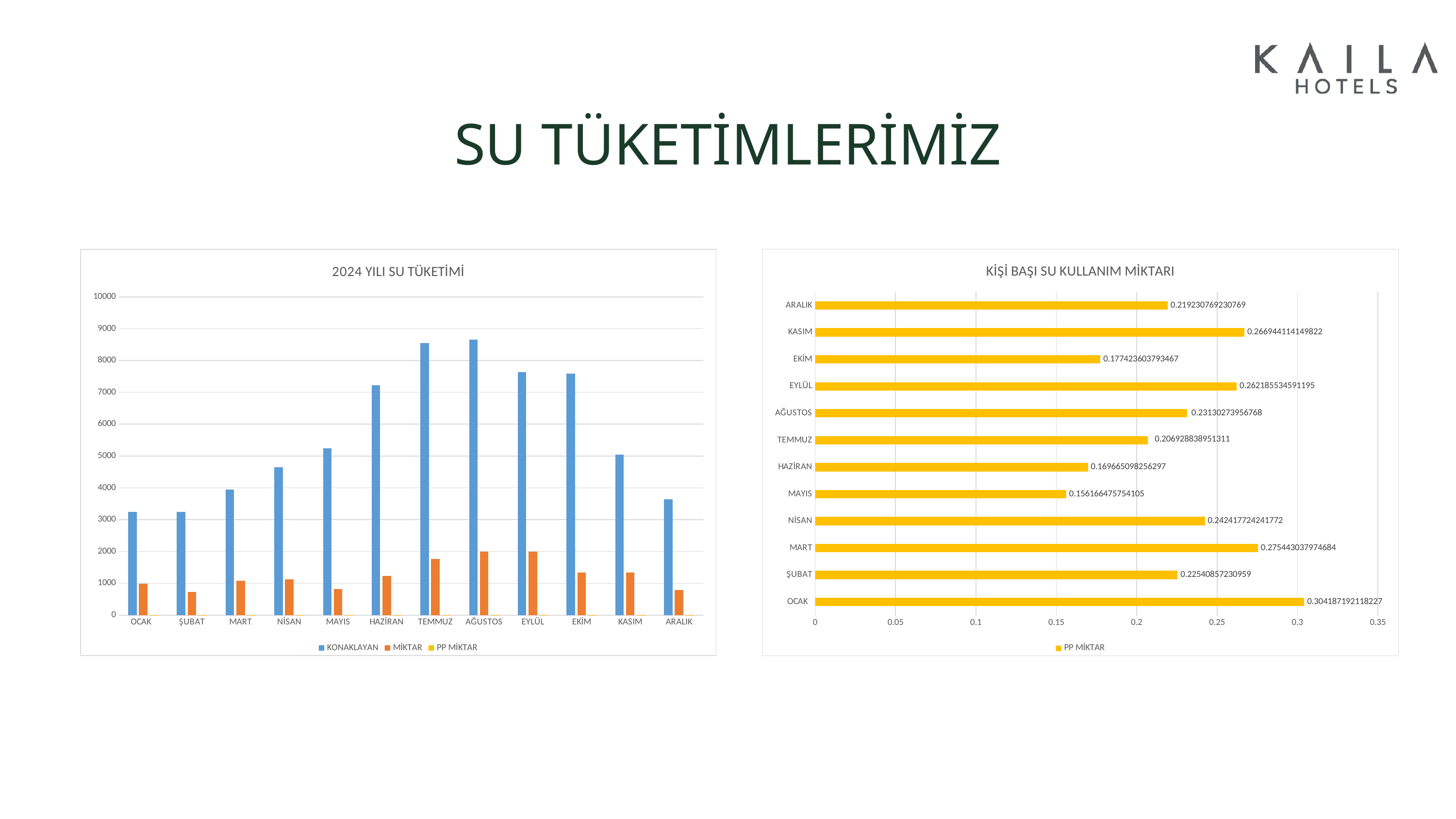
In the chart titled 'KİŞİ BAŞI SU KULLANIM MİKTARI', how many months are shown? 12 In the chart titled 'KİŞİ BAŞI SU KULLANIM MİKTARI', what is the value for KASIM? 0.266944114149822 In the chart titled 'KİŞİ BAŞI SU KULLANIM MİKTARI', which month has the highest value? OCAK In the chart titled 'KİŞİ BAŞI SU KULLANIM MİKTARI', which month has the lowest value? MAYIS In the chart titled 'KİŞİ BAŞI SU KULLANIM MİKTARI', what is the value for MAYIS? 0.156166475754105 In the chart titled '2024 YILI SU TÜKETİMİ', which is larger, the KONAKLAYAN value for TEMMUZ or for NİSAN? TEMMUZ In the chart titled '2024 YILI SU TÜKETİMİ', how many series does the legend list? 3 In the chart titled 'KİŞİ BAŞI SU KULLANIM MİKTARI', what is the value for OCAK? 0.304187192118227 In the chart titled '2024 YILI SU TÜKETİMİ', is the MİKTAR value for ŞUBAT greater or less than 1000? less In the chart titled 'KİŞİ BAŞI SU KULLANIM MİKTARI', which is larger, the value for MART or the value for EKİM? MART In the chart titled '2024 YILI SU TÜKETİMİ', is the KONAKLAYAN value for HAZİRAN greater or less than 7000? greater What kind of chart is the chart titled 'KİŞİ BAŞI SU KULLANIM MİKTARI'? Bar chart